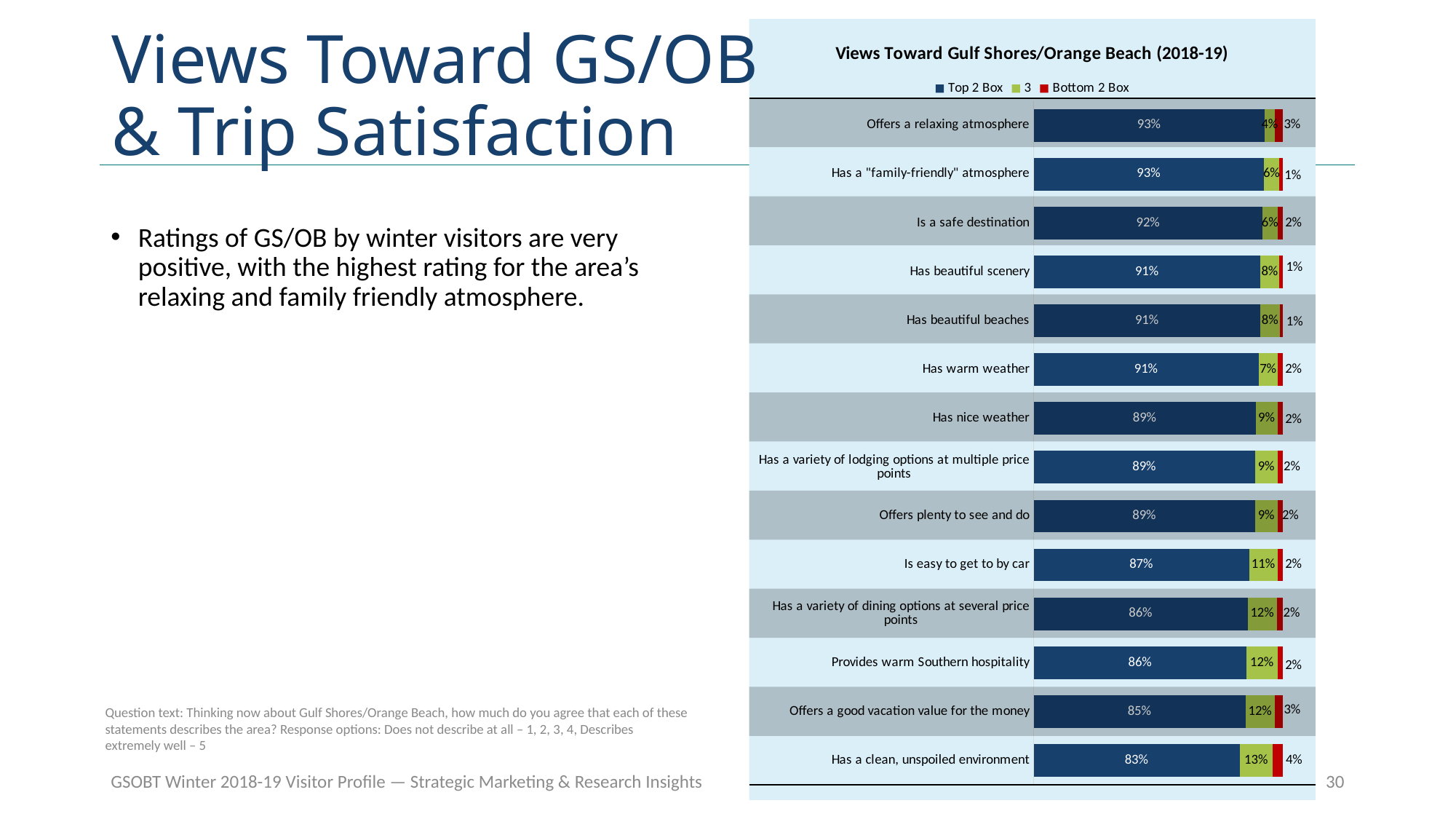
Which statement has the lowest Top 2 Box value? Has a clean, unspoiled environment Which statement has the highest Bottom 2 Box value? Has a clean, unspoiled environment How many statements are shown in the chart? 14 How many series does the legend list? 3 What is the title of the chart? Views Toward Gulf Shores/Orange Beach (2018-19) What is the Bottom 2 Box value for "Offers a relaxing atmosphere"? 3% Which has a larger Top 2 Box value: "Has warm weather" or "Is easy to get to by car"? Has warm weather What is the difference between the Top 2 Box values for "Offers a relaxing atmosphere" and "Has a clean, unspoiled environment"? 10% What is the value of the "3" series for "Is easy to get to by car"? 11% What is the Top 2 Box value for "Is a safe destination"? 92% What is the Top 2 Box value for "Provides warm Southern hospitality"? 86% What kind of chart is shown on the slide? Stacked bar chart